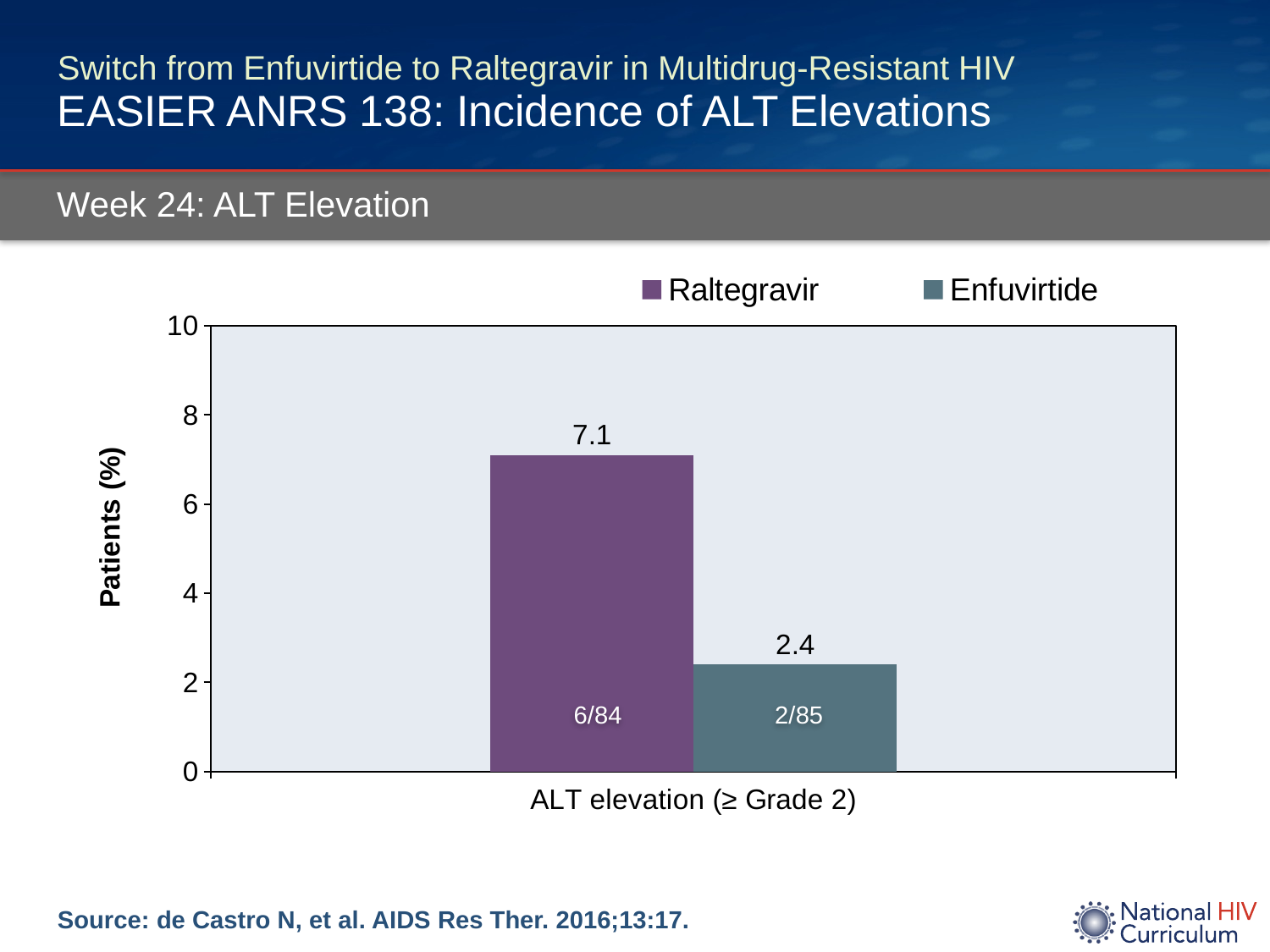
What is the label of the y axis? Patients (%) What is the value for Enfuvirtide for ALT elevation (≥ Grade 2)? 2.4 Is the value for Enfuvirtide greater or less than 4? less What fraction of patients is printed on the Raltegravir bar? 6/84 How many series does the legend list? 2 Which series has the higher value for ALT elevation (≥ Grade 2)? Raltegravir What is the difference between the Raltegravir and Enfuvirtide values for ALT elevation (≥ Grade 2)? 4.7 What is the value for Raltegravir for ALT elevation (≥ Grade 2)? 7.1 What kind of chart is shown on the slide? bar chart Which series has the lower value for ALT elevation (≥ Grade 2)? Enfuvirtide Is the value for Raltegravir larger or smaller than the value for Enfuvirtide? larger Is the value for Raltegravir greater or less than 6? greater